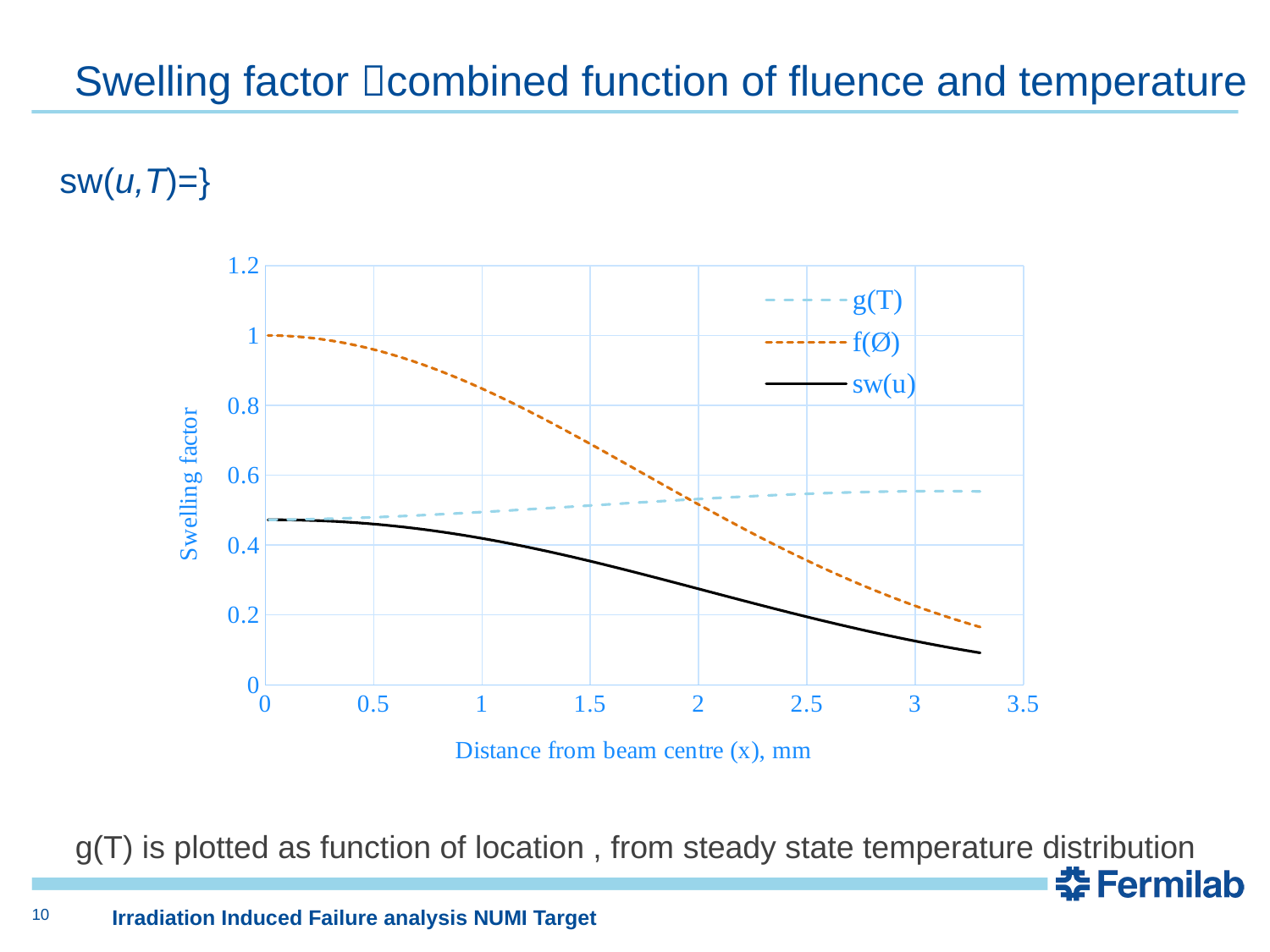
Is the value of g(T) at a distance of 3 mm greater or less than 0.4? greater What is the title of the horizontal axis of the chart? Distance from beam centre (x), mm Is the value of f(Ø) at a distance of 3 mm greater or less than 0.4? less At a distance of 3 mm from the beam centre, which is larger: g(T) or f(Ø)? g(T) What is the title of the vertical axis of the chart? Swelling factor Is the value of sw(u) at a distance of 2 mm greater or less than 0.4? less What kind of chart is shown on the slide? line chart What is the value of f(Ø) at a distance of 0 mm from the beam centre? 1 Does the sw(u) curve rise or fall as the distance from the beam centre increases? fall How many series does the chart legend list? 3 Does the f(Ø) curve rise or fall as the distance from the beam centre increases? fall Does the g(T) curve rise or fall as the distance from the beam centre increases? rise